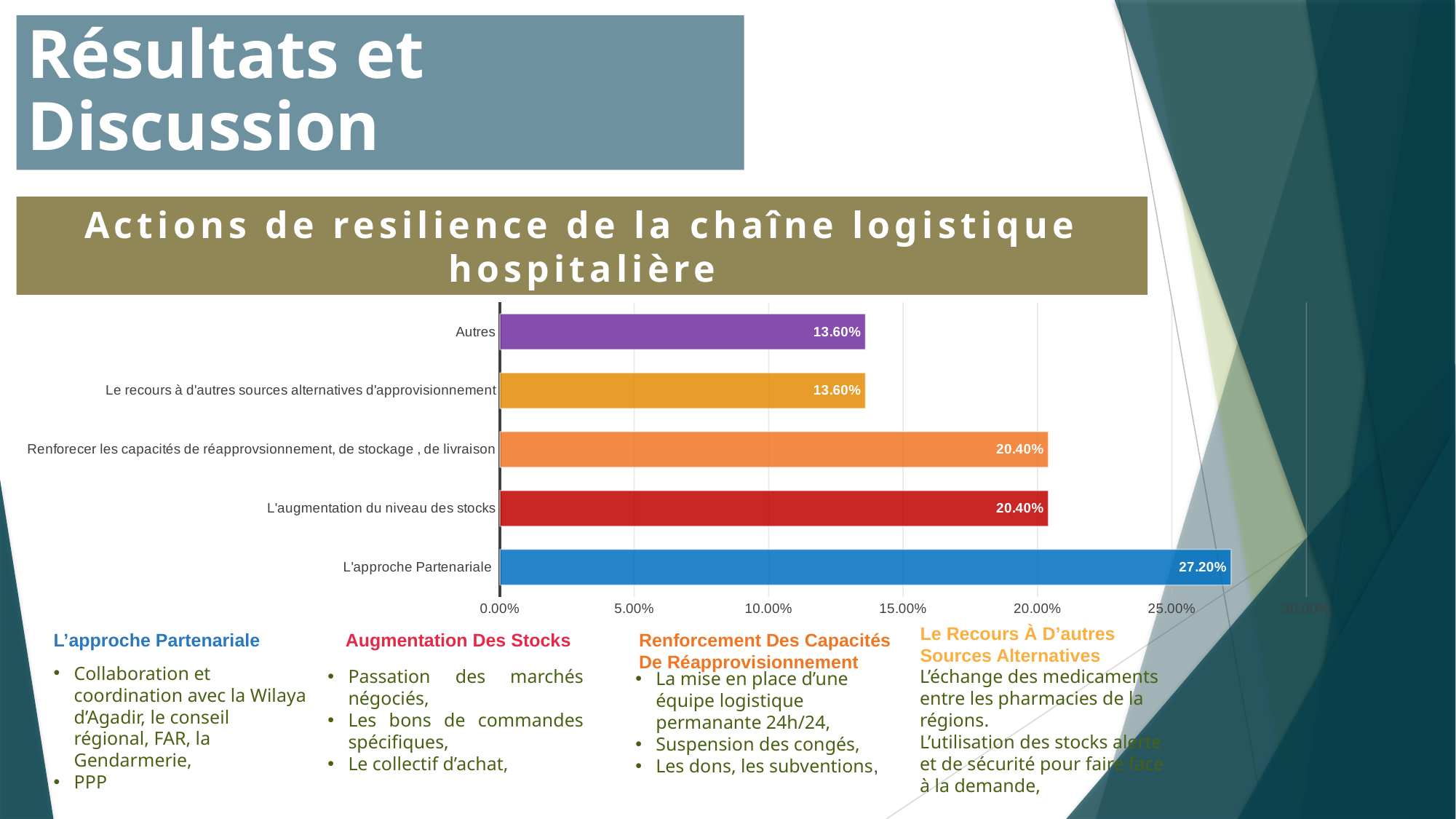
What is the value for Le recours à d'autres sources alternatives d'approvisionnement? 13.60% What is the value for L'augmentation du niveau des stocks? 20.40% How many categories are shown in the chart? 5 Is the value for L'approche Partenariale greater or less than 25.00%? greater Which is larger, the value for L'approche Partenariale or the value for Autres? L'approche Partenariale What is the value for Autres? 13.60% What is the lowest value shown in the chart? 13.60% What is the difference between the value for Renforecer les capacités de réapprovsionnement, de stockage, de livraison and the value for Autres? 6.80% Which category has the highest value? L'approche Partenariale What is the value for L'approche Partenariale? 27.20% What kind of chart is shown on the slide? bar chart What is the difference between the value for L'approche Partenariale and the value for L'augmentation du niveau des stocks? 6.80%